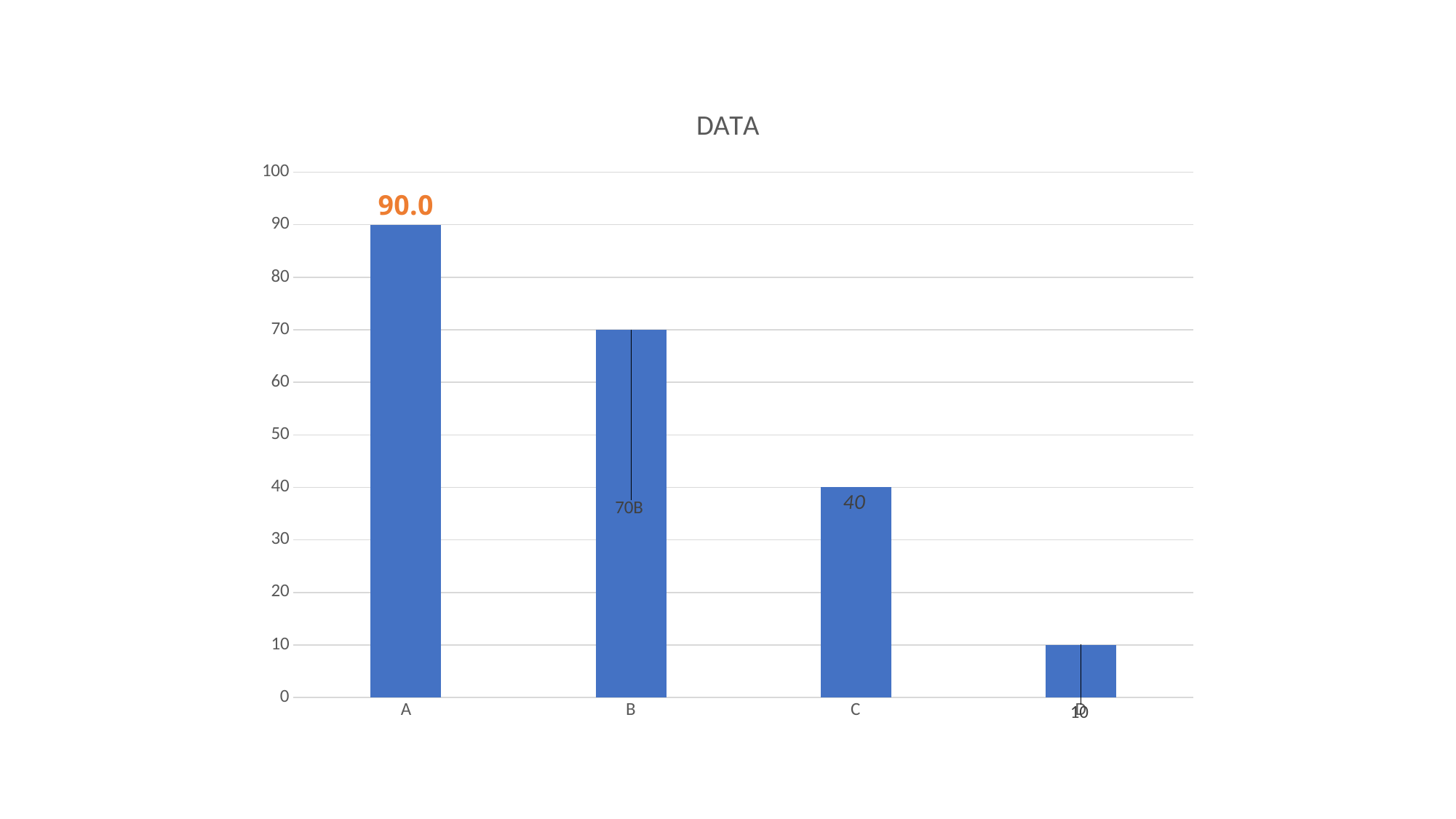
Which is larger, the value for B or the value for C? B What is the value for category A? 90.0 What is the value of the rightmost bar? 10 Which bar has the lowest value? The rightmost bar (D) How many bars are shown in the chart? 4 What is the value for category B? 70 Is the value for C greater or less than 50? less What is the value for category C? 40 Do the values rise or fall from left to right along the x axis? Fall What is the difference between the values for A and B? 20 Which category has the highest value? A What kind of chart is shown on the slide? Bar chart